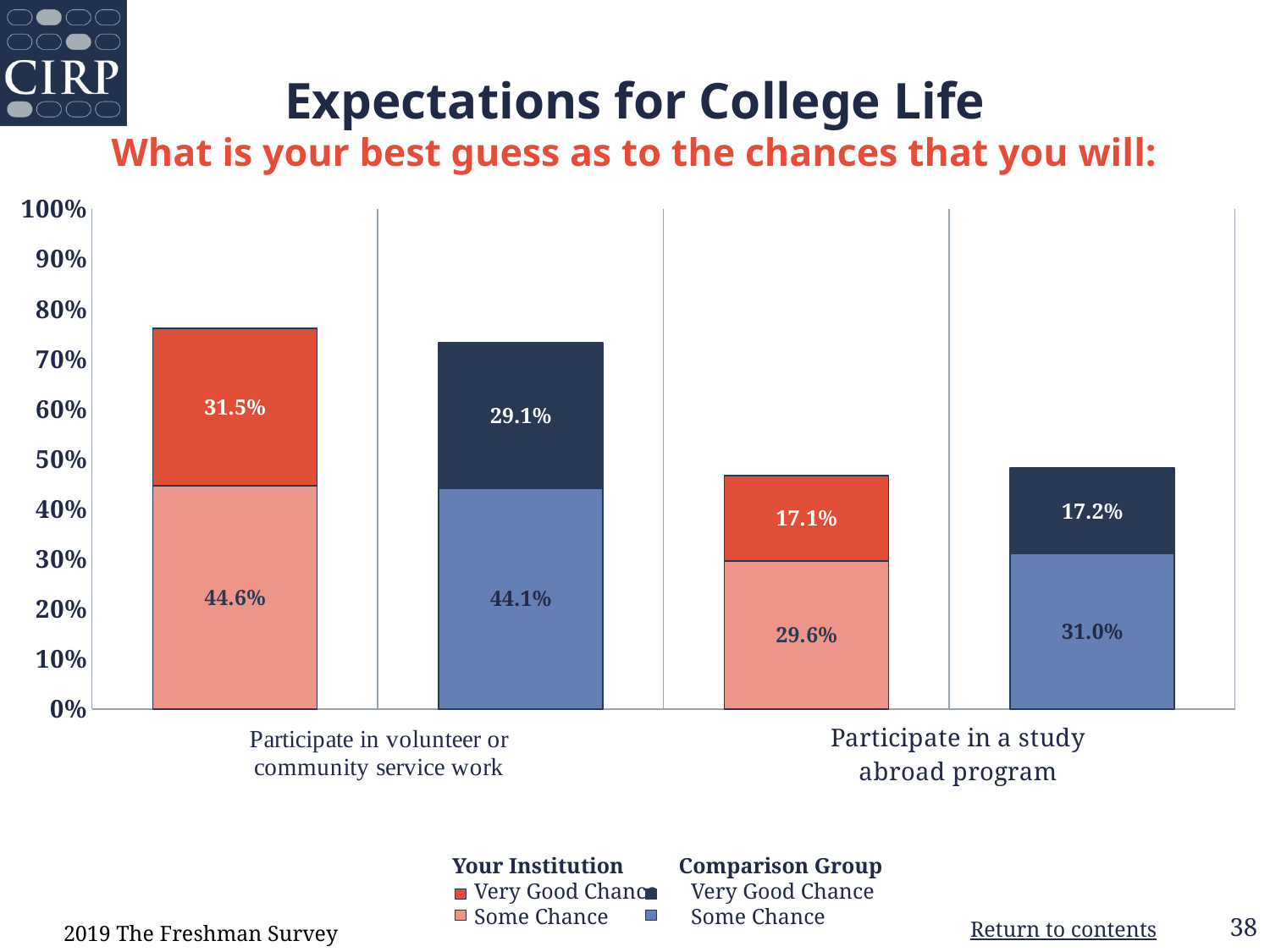
What is the difference between the Your Institution and Comparison Group Very Good Chance values for participating in volunteer or community service work? 2.4 percentage points What is the total height of the Your Institution stacked bar for participating in volunteer or community service work? 76.1% What percentage of Your Institution students said there is Some Chance they will participate in a study abroad program? 29.6% What kind of chart is shown on the slide? Stacked bar chart What percentage of the Comparison Group said there is a Very Good Chance they will participate in volunteer or community service work? 29.1% Which is larger for Some Chance of participating in a study abroad program: Your Institution or the Comparison Group? Comparison Group What is the total height of the Comparison Group stacked bar for participating in a study abroad program? 48.2% Is the total Your Institution bar for participating in a study abroad program greater or less than 50%? less What percentage of the Comparison Group said there is Some Chance they will participate in a study abroad program? 31.0% What colour represents Very Good Chance for Your Institution? Red How many entries does the legend list? 4 What percentage of Your Institution students said there is a Very Good Chance they will participate in volunteer or community service work? 31.5%